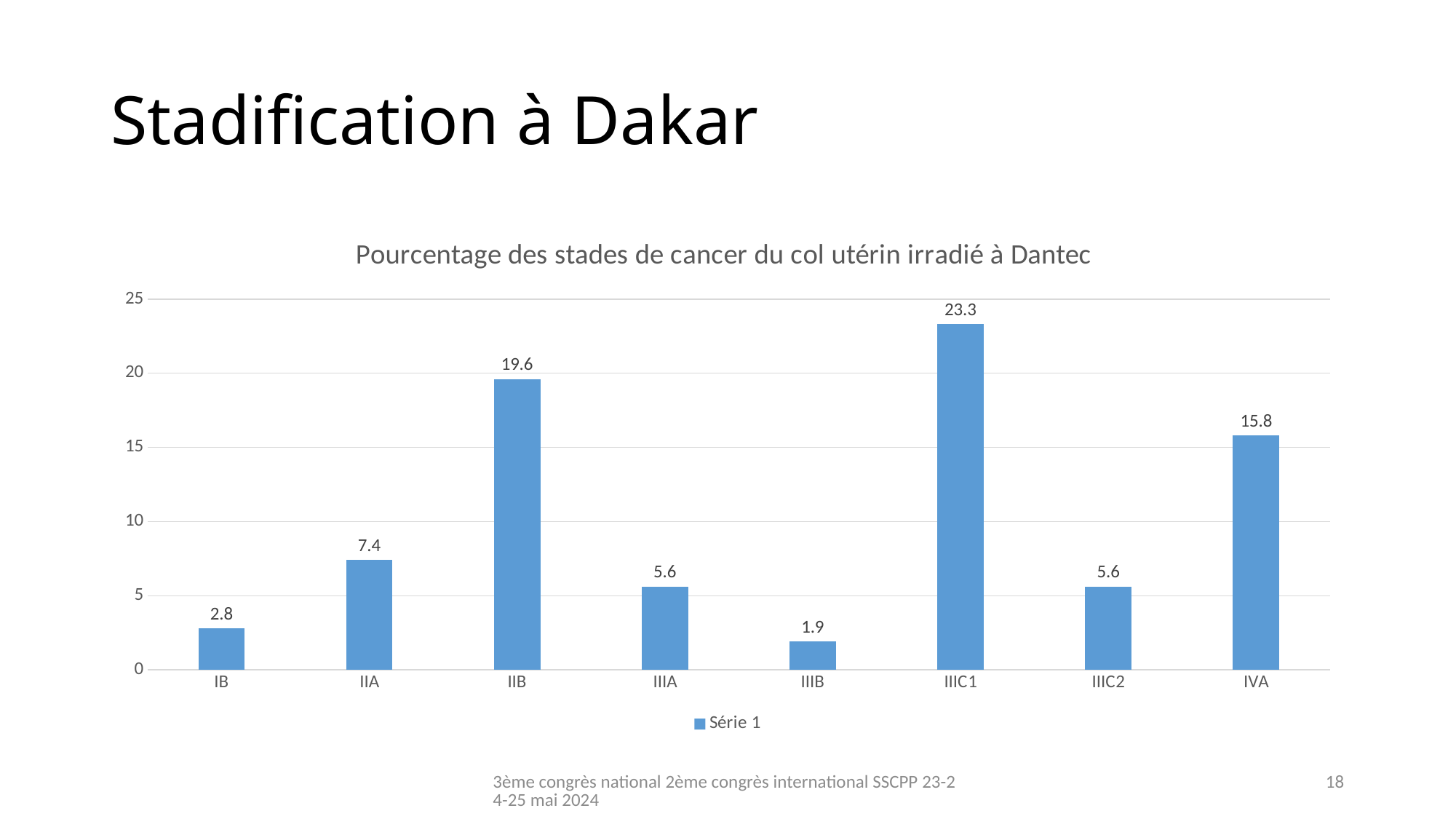
What is the value for stage IVA? 15.8 Which stage has the lowest value? IIIB Which is larger, the value for IIB or the value for IVA? IIB What is the difference between the values for IIA and IB? 4.6 What kind of chart is shown on the slide? bar chart What is the title of the chart? Pourcentage des stades de cancer du col utérin irradié à Dantec What is the value for stage IIIC1? 23.3 How many stages are shown on the x axis? 8 Is the value for IIIC1 greater or less than 20? greater What is the value for stage IB? 2.8 What is the difference between the values for IIIC1 and IIB? 3.7 Which stage has the highest value? IIIC1